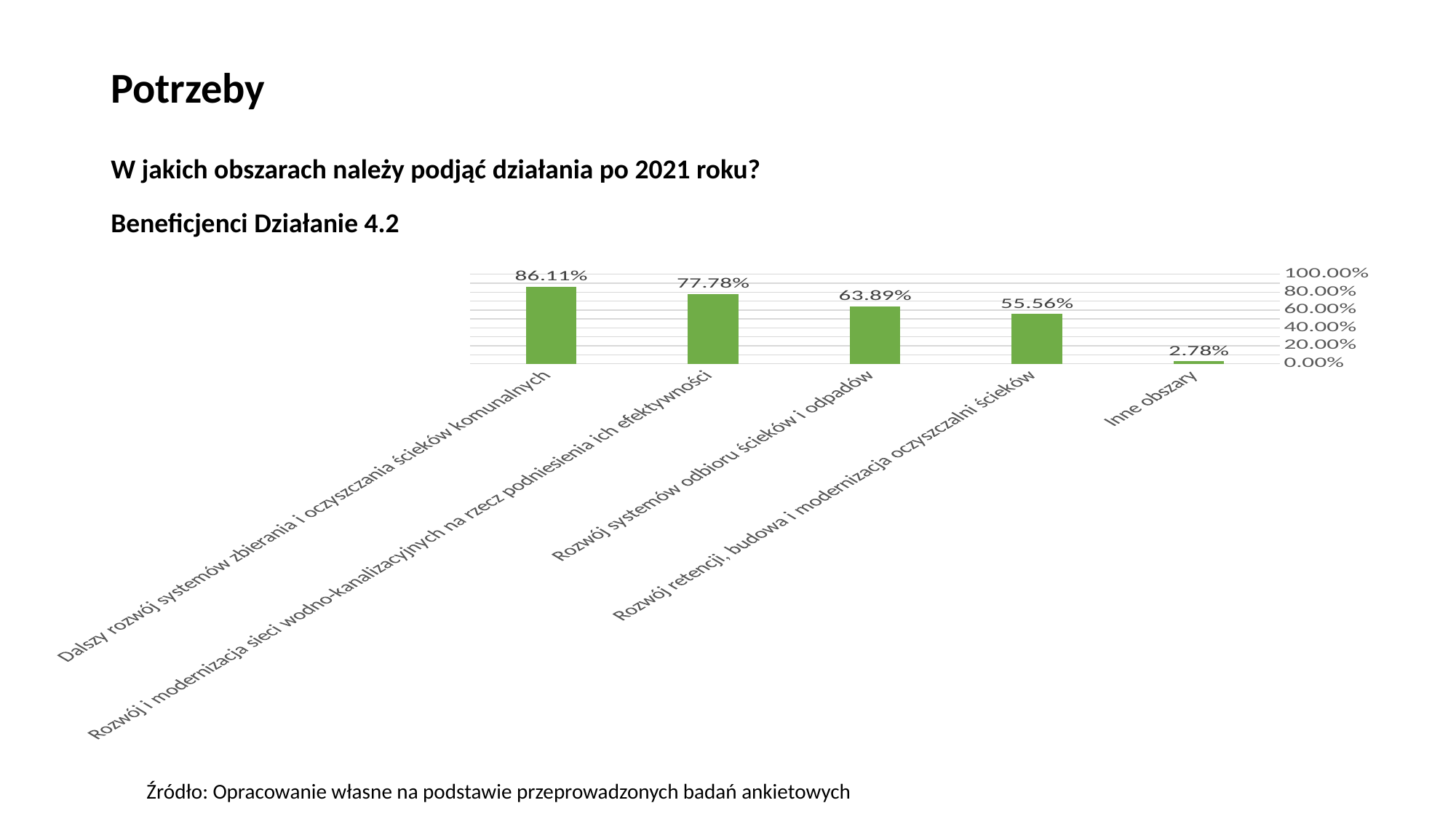
What is the value for "Dalszy rozwój systemów zbierania i oczyszczania ścieków komunalnych"? 86.11% How many categories are shown in the chart? 5 Which is larger: the value for "Rozwój systemów odbioru ścieków i odpadów" or the value for "Rozwój retencji, budowa i modernizacja oczyszczalni ścieków"? Rozwój systemów odbioru ścieków i odpadów What is the difference between the values for "Dalszy rozwój systemów zbierania i oczyszczania ścieków komunalnych" and "Rozwój retencji, budowa i modernizacja oczyszczalni ścieków"? 30.55% What is the value for "Rozwój systemów odbioru ścieków i odpadów"? 63.89% What is the value for "Rozwój retencji, budowa i modernizacja oczyszczalni ścieków"? 55.56% Which category has the highest value? Dalszy rozwój systemów zbierania i oczyszczania ścieków komunalnych What kind of chart is shown on the slide? bar chart Which category has the lowest value? Inne obszary What is the value for "Inne obszary"? 2.78% Is the value for "Rozwój i modernizacja sieci wodno-kanalizacyjnych na rzecz podniesienia ich efektywności" greater or less than 60.00%? greater What is the value for "Rozwój i modernizacja sieci wodno-kanalizacyjnych na rzecz podniesienia ich efektywności"? 77.78%